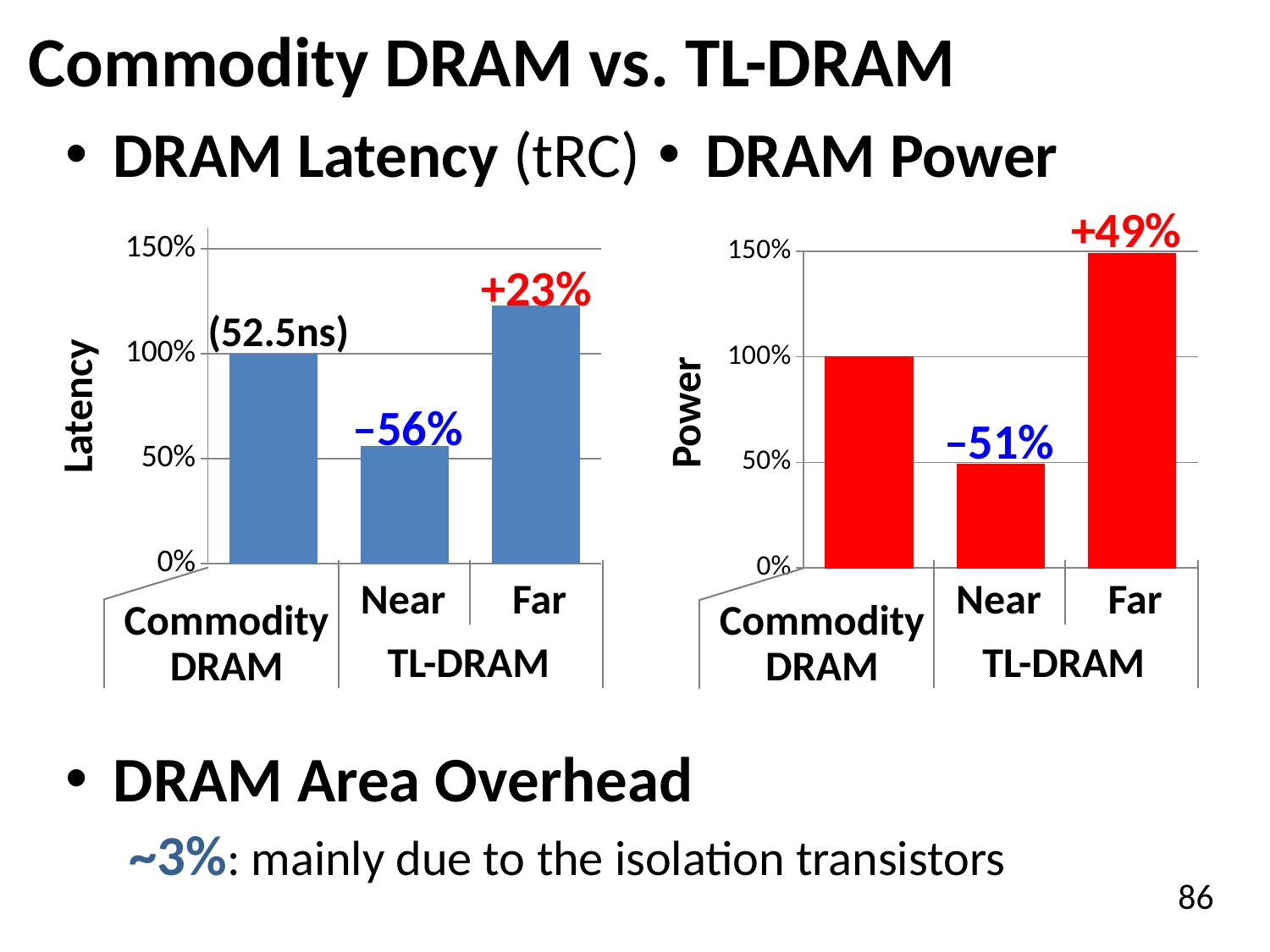
In the DRAM Latency chart, what value does the Commodity DRAM bar reach on the y axis? 100% In the DRAM Latency chart, what absolute latency value is printed next to the Commodity DRAM bar? (52.5ns) In the DRAM Power chart, what label is printed above the Near bar? –51% In the DRAM Power chart, which bar is the highest? Far What kind of chart is the DRAM Latency chart? bar chart How many bars are plotted in the DRAM Power chart? 3 In the DRAM Latency chart, what label is printed above the Far bar? +23% In the DRAM Power chart, is the value for Near greater or less than 100%? less In the DRAM Latency chart, what label is printed above the Near bar? –56% In the DRAM Power chart, what label is printed above the Far bar? +49% In the DRAM Latency chart, is the value for Far greater or less than 100%? greater In the DRAM Latency chart, which bar is the lowest? Near